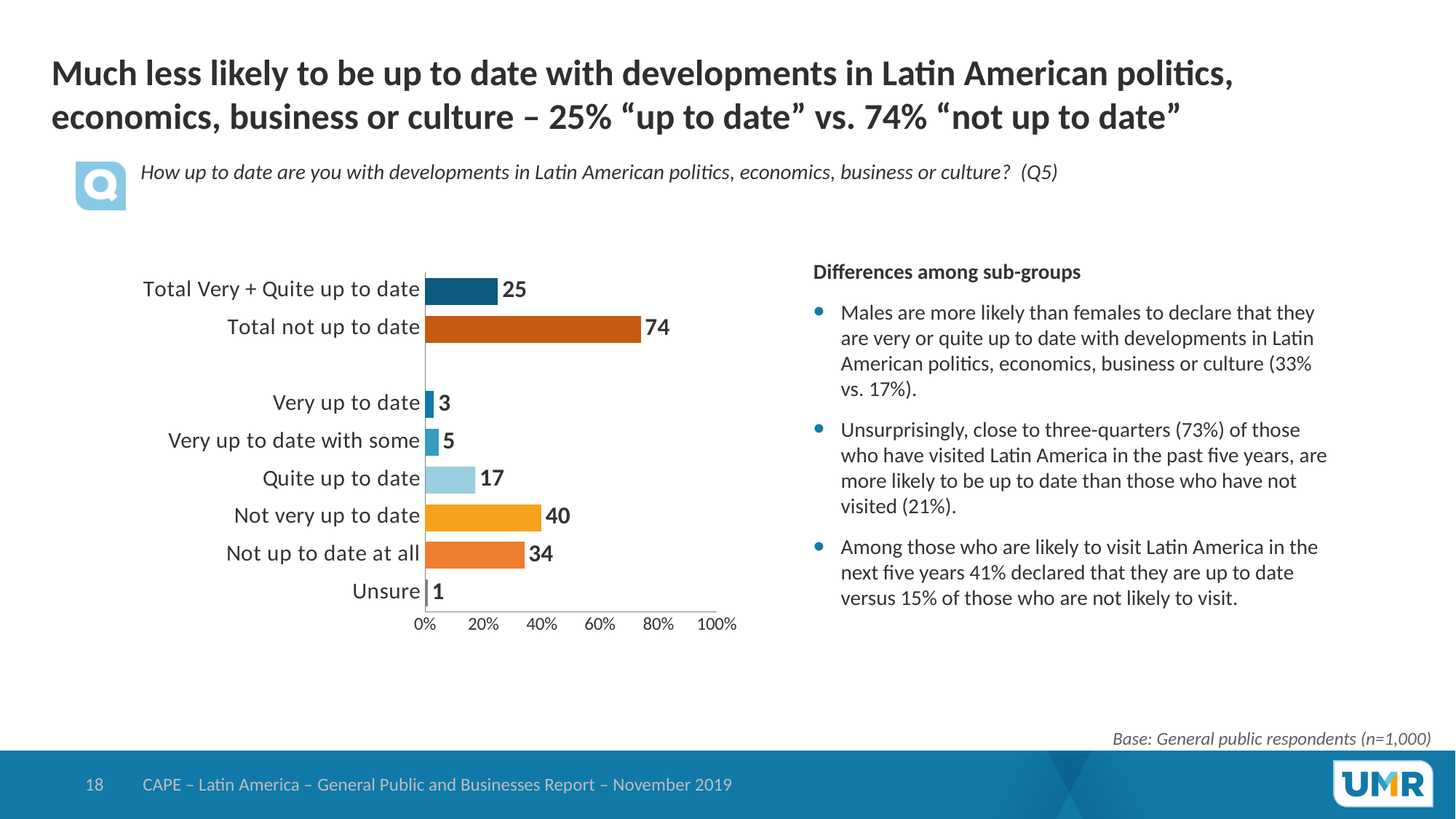
Which category has the highest value? Total not up to date Which is larger, "Quite up to date" or "Very up to date"? Quite up to date What is the value for "Quite up to date"? 17 What is the difference between "Total not up to date" and "Total Very + Quite up to date"? 49 Is the value for "Total not up to date" greater or less than 60%? greater How many categories are shown in the chart? 8 What kind of chart is shown on the slide? Bar chart What is the value for "Not very up to date"? 40 What is the value for "Very up to date with some"? 5 What is the difference between "Not very up to date" and "Not up to date at all"? 6 Which category has the lowest value? Unsure What is the value for "Total not up to date"? 74